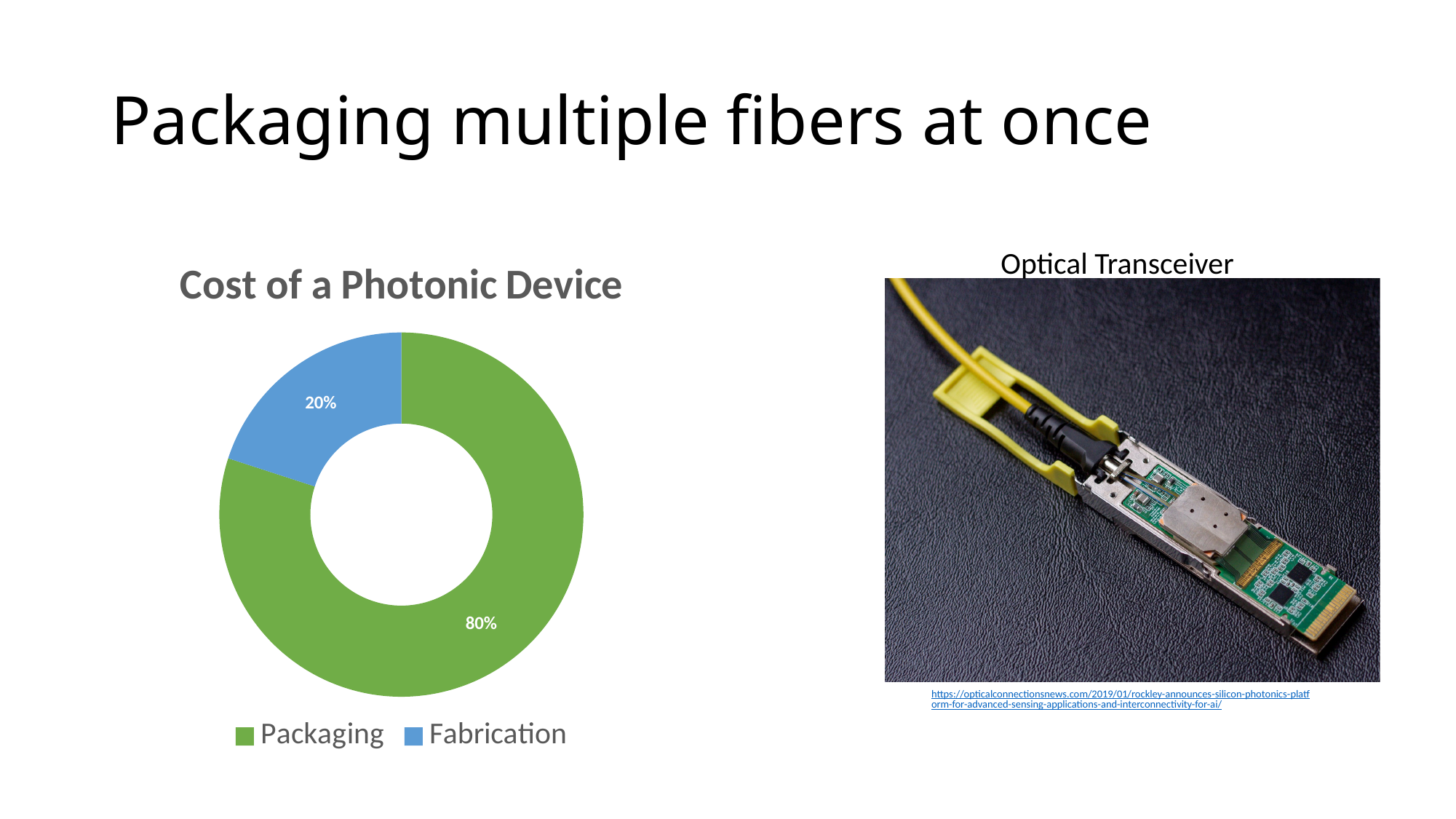
By how many percentage points does the Packaging share exceed the Fabrication share? 60 percentage points Which colour represents Fabrication in the chart? Blue What is the title of the chart? Cost of a Photonic Device What kind of chart is used to show the cost of a photonic device? Pie chart (doughnut) Which category accounts for the largest share of the cost of a photonic device? Packaging What share of the cost of a photonic device is attributed to Fabrication? 20% What share of the cost of a photonic device is attributed to Packaging? 80% Which category accounts for the smallest share of the cost of a photonic device? Fabrication How many categories does the pie chart show? 2 Which is larger: the Packaging share or the Fabrication share? Packaging Is the Packaging share greater or less than 50%? greater